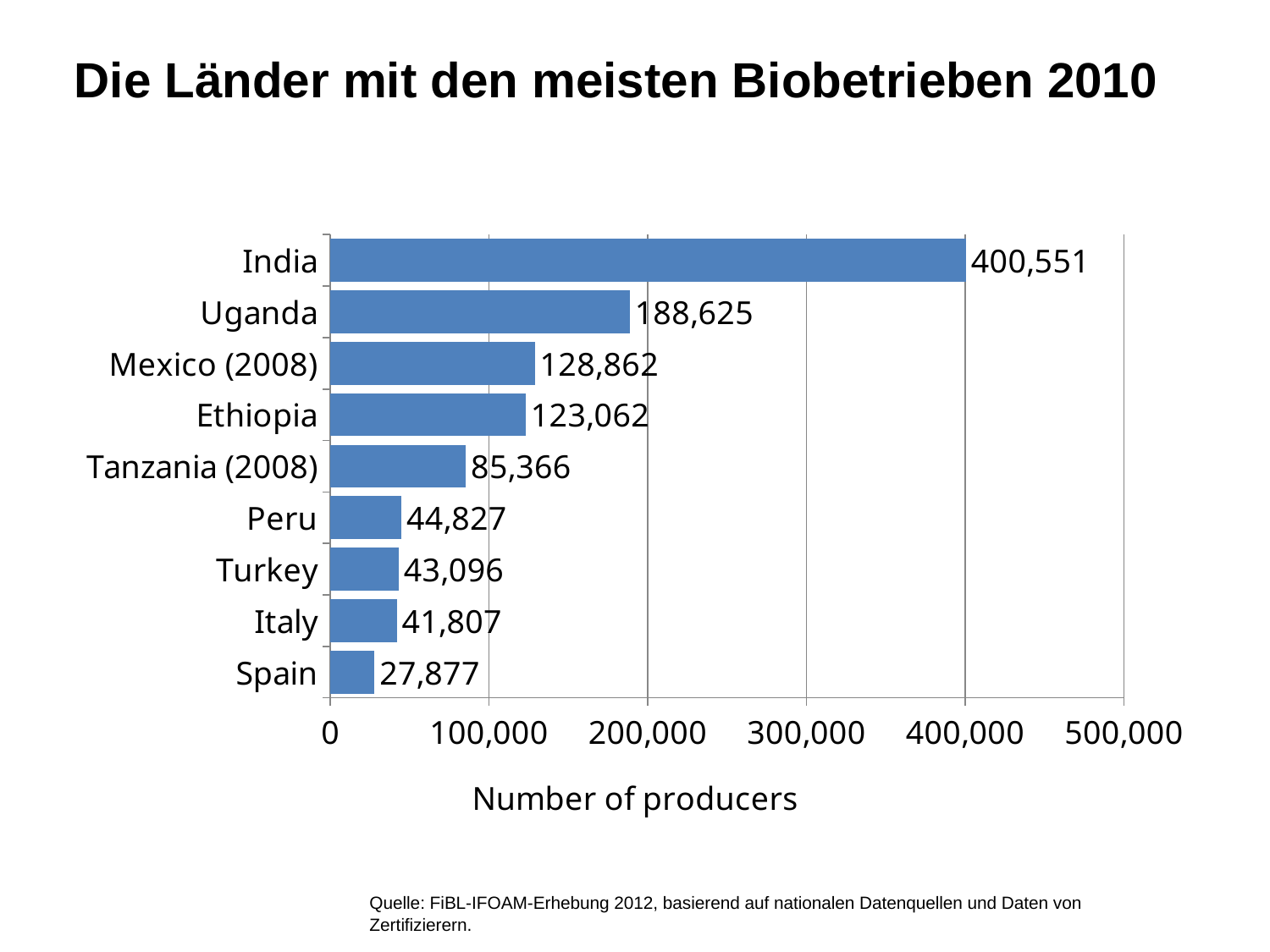
Which country has the highest number of producers? India Which country has the lowest number of producers? Spain What is the difference in number of producers between Mexico (2008) and Ethiopia? 5,800 What is the difference in number of producers between India and Uganda? 211,926 Is the number of producers for Uganda greater or less than 200,000? less What is the label of the horizontal axis? Number of producers How many countries are shown in the chart? 9 Which has more producers, Tanzania (2008) or Peru? Tanzania (2008) What is the number of producers for India? 400,551 What kind of chart is shown on the slide? bar chart What is the number of producers for Spain? 27,877 What is the number of producers for Ethiopia? 123,062